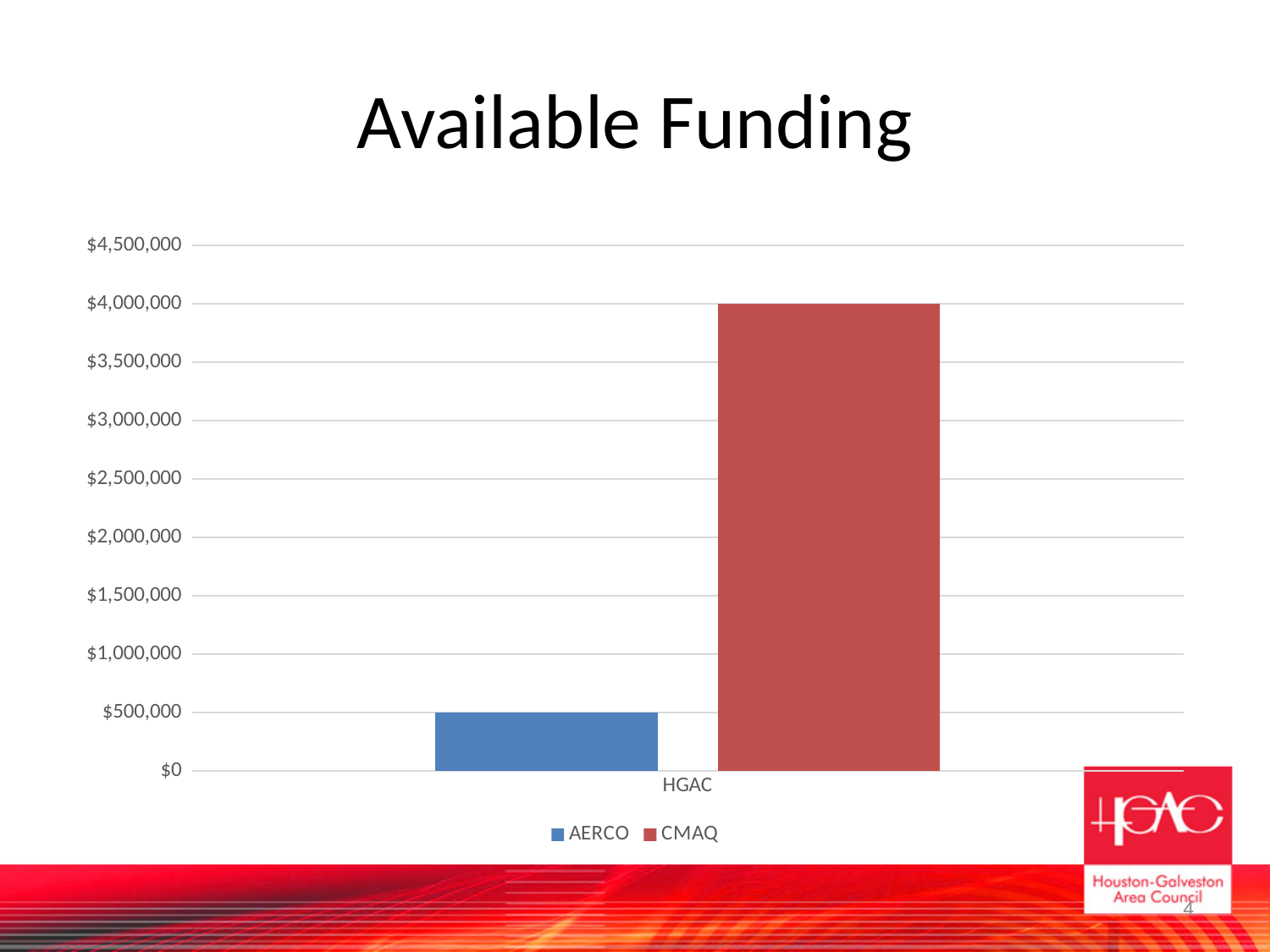
Which series has the highest value in the chart? CMAQ What kind of chart is shown on the slide? Bar chart How many series does the legend list? 2 How many categories are shown on the x axis? 1 What is the title of the slide containing the chart? Available Funding Which series has the lowest value in the chart? AERCO Is the value for CMAQ greater or less than $3,000,000? greater Which series has the higher value, AERCO or CMAQ? CMAQ What is the value for CMAQ in the Available Funding chart? $4,000,000 What is the difference between the CMAQ value and the AERCO value? $3,500,000 What is the value for AERCO in the Available Funding chart? $500,000 Is the value for AERCO greater or less than $1,000,000? less